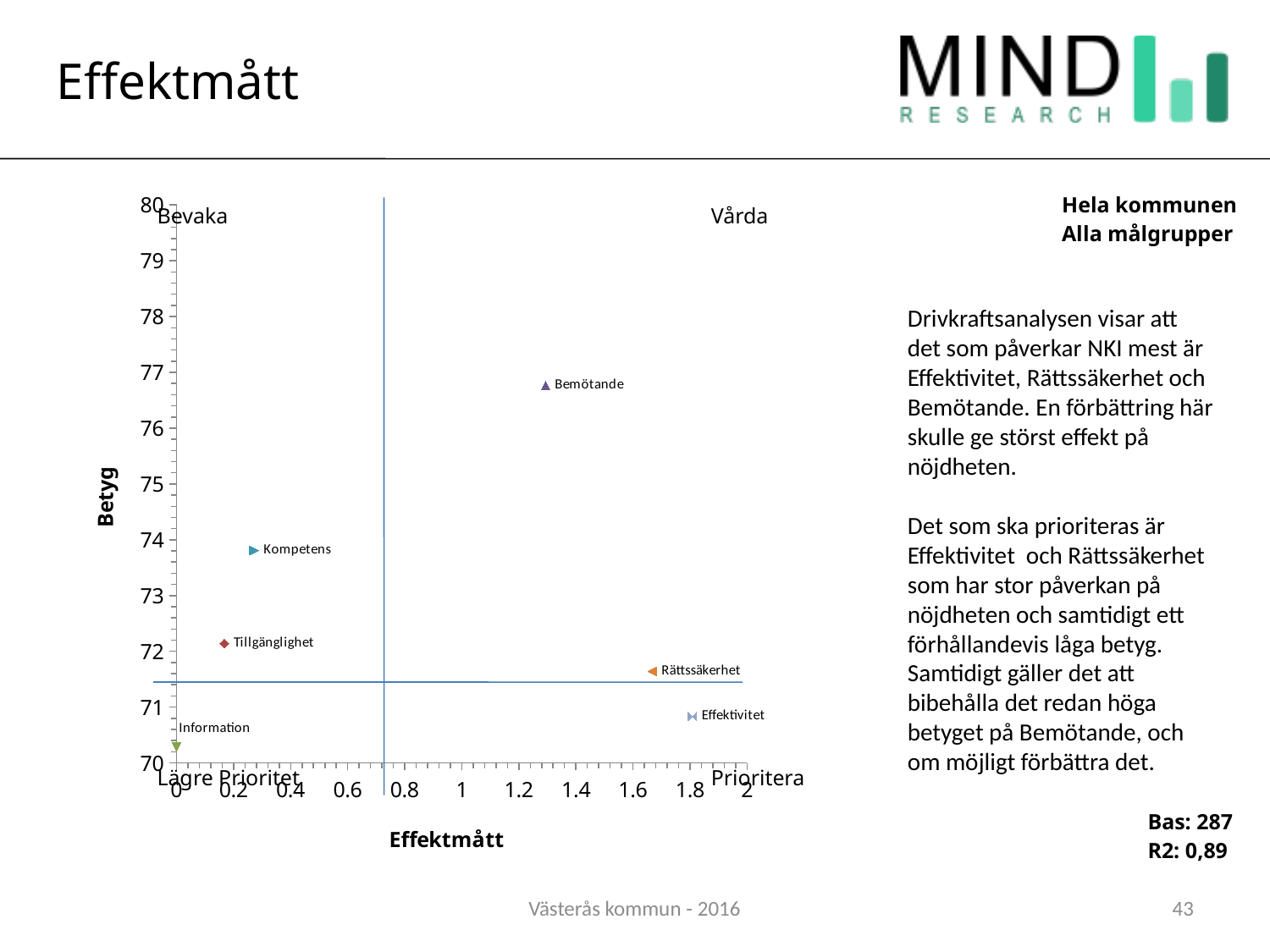
Which data point has the lowest Effektmått value? Information Which data point has the highest Betyg value? Bemötande Is the Betyg value for Effektivitet greater or less than 71? less Is the Betyg value for Bemötande greater or less than 76? greater What is the title of the horizontal axis of the chart? Effektmått What kind of chart is shown on the slide? scatter chart Is the Betyg value for Kompetens greater or less than 73? greater Which has a higher Betyg value, Kompetens or Tillgänglighet? Kompetens Which data point has the lowest Betyg value? Information Which data point has the highest Effektmått value? Effektivitet How many labelled data points are plotted in the chart? 6